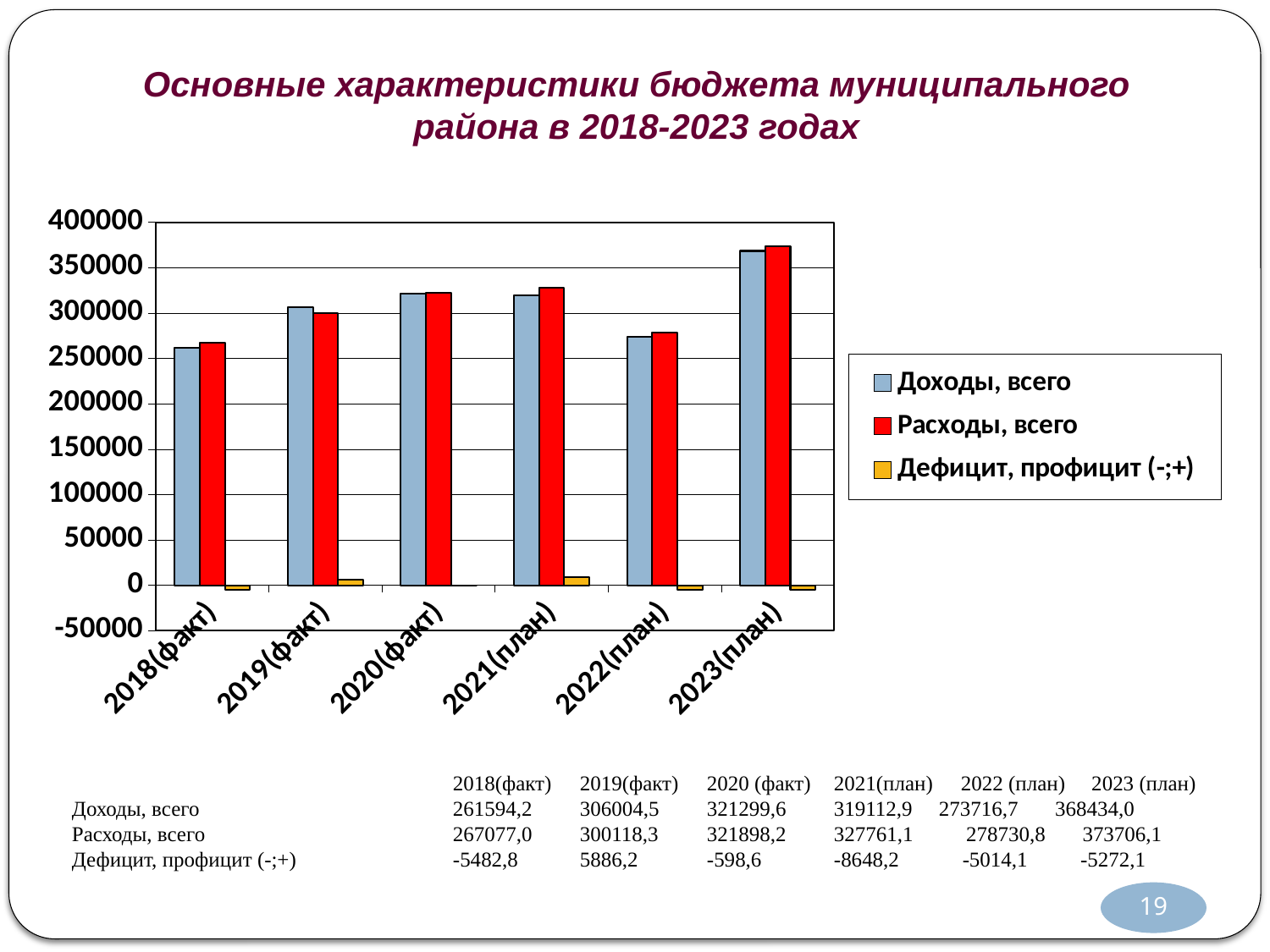
How many series does the legend list? 3 What is the value of Расходы, всего for 2021(план)? 327761,1 Which year has the highest value of Доходы, всего? 2023(план) Is the value of Доходы, всего for 2022(план) greater or less than 300000? less What is the value of Доходы, всего for 2019(факт)? 306004,5 Which year has the lowest value of Расходы, всего? 2018(факт) What kind of chart is shown on the slide? bar chart How many years are shown on the x axis of the chart? 6 What is the difference between Расходы, всего and Доходы, всего in 2023(план)? 5272,1 What is the value of Дефицит, профицит (-;+) for 2018(факт)? -5482,8 Does Доходы, всего rise or fall from 2018(факт) to 2020(факт)? rise In 2019(факт), which is larger: Доходы, всего or Расходы, всего? Доходы, всего